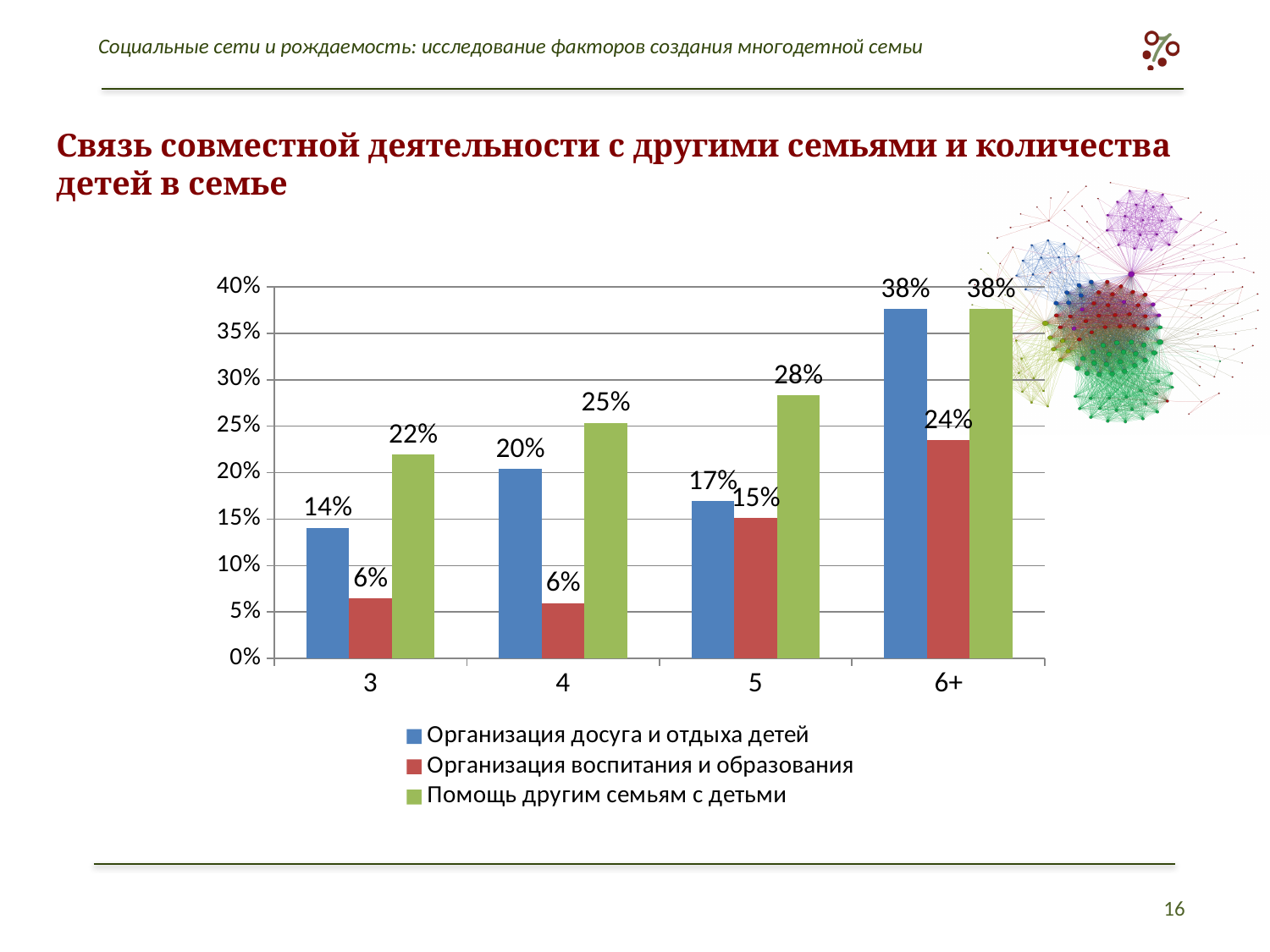
What is the value for 'Помощь другим семьям с детьми' in category 5? 28% Do the values for 'Помощь другим семьям с детьми' rise or fall from category 3 to 6+? rise Which is larger in category 5: 'Организация досуга и отдыха детей' or 'Помощь другим семьям с детьми'? Помощь другим семьям с детьми Is the value for 'Организация воспитания и образования' in category 5 greater or less than 10%? greater In which category is 'Организация досуга и отдыха детей' lowest? 3 In which category is 'Помощь другим семьям с детьми' highest? 6+ How many series does the legend list? 3 What is the value for 'Организация воспитания и образования' in category 6+? 24% What kind of chart is shown on the slide? bar chart What is the difference between 'Помощь другим семьям с детьми' and 'Организация воспитания и образования' in category 4? 19% How many categories are shown on the x axis? 4 What is the value for 'Организация досуга и отдыха детей' in category 3? 14%